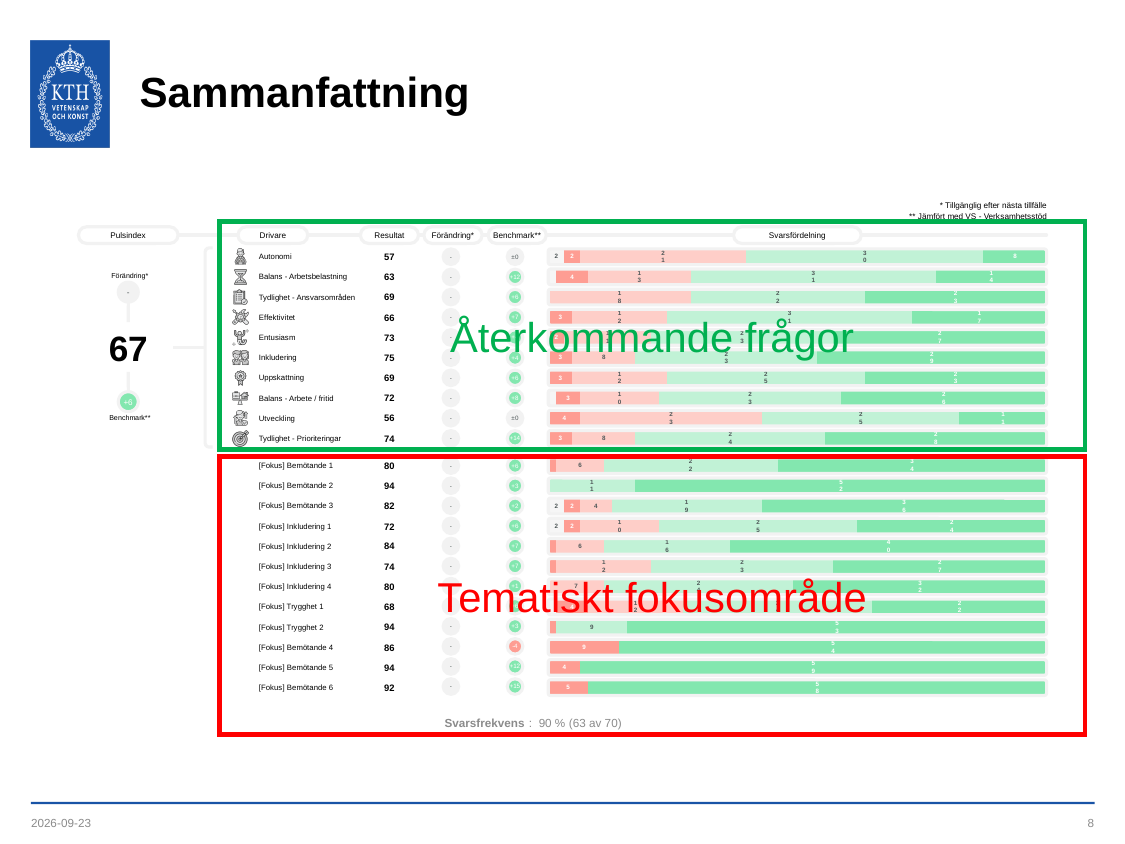
What is the Pulsindex value shown on the slide? 67 What is the Resultat value for [Fokus] Inkludering 2? 84 Which item in the 'Tematiskt fokusområde' section has the lowest Resultat? [Fokus] Trygghet 1 What is the Resultat value for Utveckling? 56 What is the difference in Resultat between Inkludering and Autonomi? 18 Which has a higher Resultat, Entusiasm or Effektivitet? Entusiasm What is the Resultat value for Autonomi? 57 Which driver in the 'Återkommande frågor' section has the highest Resultat? Inkludering What kind of chart is used in the Svarsfördelning column? Stacked bar chart How many drivers are listed in the 'Återkommande frågor' section? 10 Which driver in the 'Återkommande frågor' section has the lowest Resultat? Utveckling How many items are listed in the 'Tematiskt fokusområde' section? 12